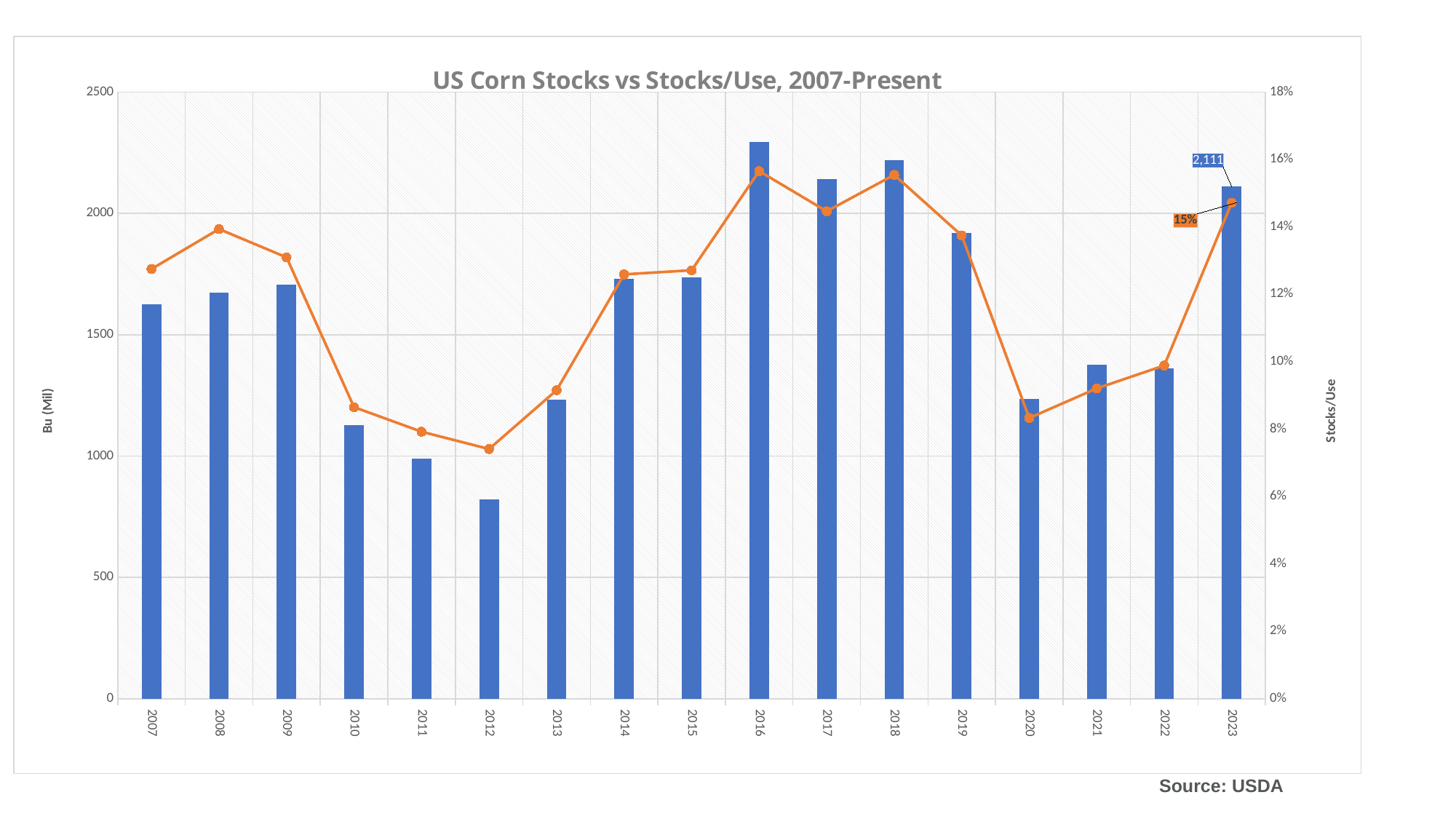
What is the title of the chart? US Corn Stocks vs Stocks/Use, 2007-Present How many years are shown on the x axis? 17 What is the labelled value of the corn stocks bar for 2023? 2,111 What type of chart is shown on the slide? Combination bar and line chart Which year has the lowest Stocks/Use value on the line? 2012 Which year has the shortest corn stocks bar? 2012 Is the Stocks/Use value for 2010 greater or less than 10%? less Do the corn stocks bars rise or fall from 2009 to 2012? fall Which year has the tallest corn stocks bar? 2016 Is the corn stocks bar for 2012 greater or less than 1000? less Which year has a taller corn stocks bar, 2016 or 2017? 2016 What is the labelled Stocks/Use value for 2023? 15%